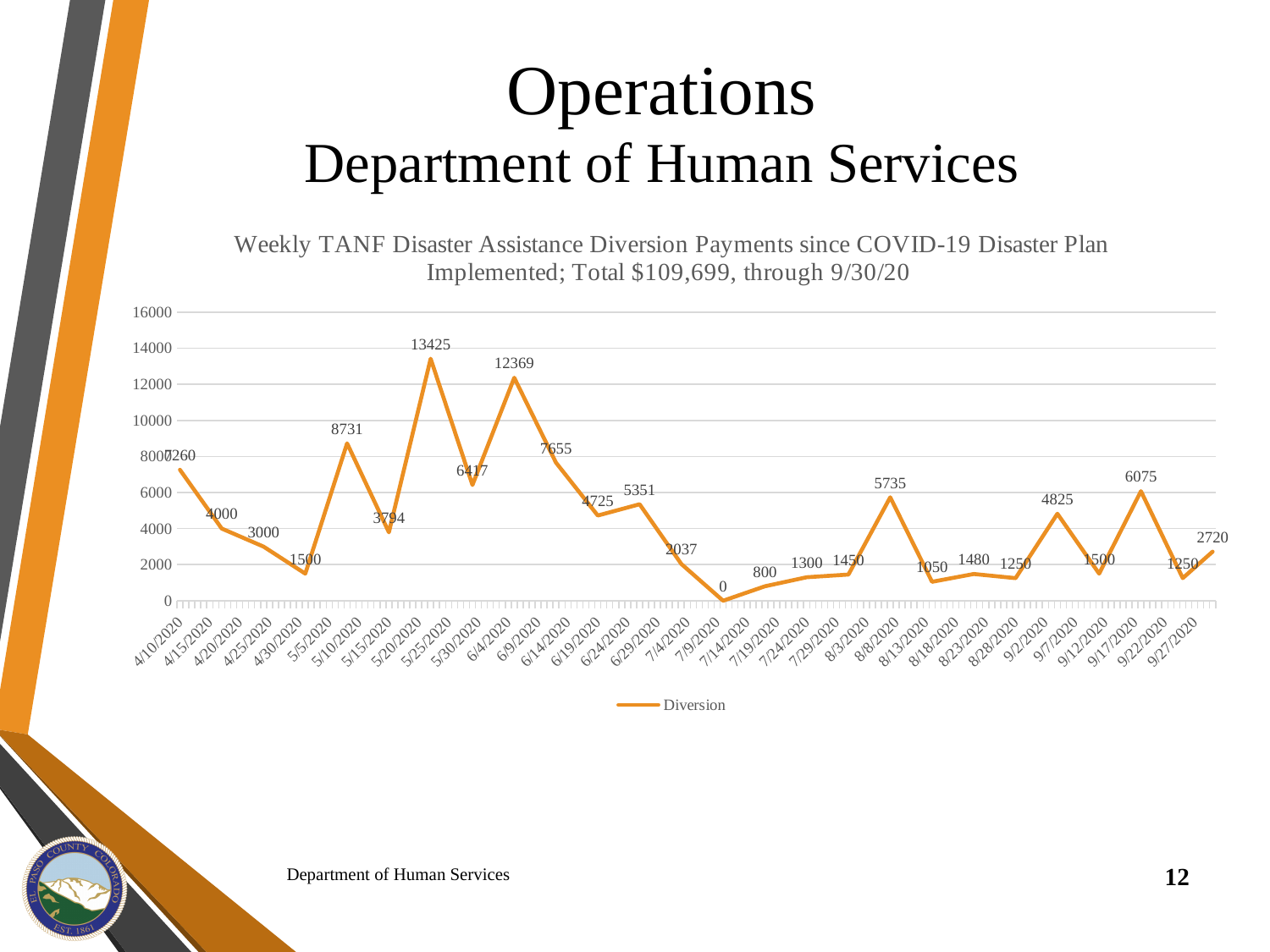
According to the chart title, what is the total of the Diversion payments through 9/30/20? $109,699 Does the Diversion line end higher or lower than it starts? lower What is the value of the last data point on the line? 2720 How many labeled data points are on the Diversion line? 26 What is the difference between the two highest labeled values, 13425 and 12369? 1056 Which is larger, the labeled value 5735 or the labeled value 6075? 6075 What is the highest weekly Diversion payment value labeled on the chart? 13425 How many series does the legend list? 1 What kind of chart is shown on the slide? line chart What is the name of the series shown in the legend? Diversion What is the value of the first data point on the line? 7260 What is the lowest weekly Diversion payment value labeled on the chart? 0